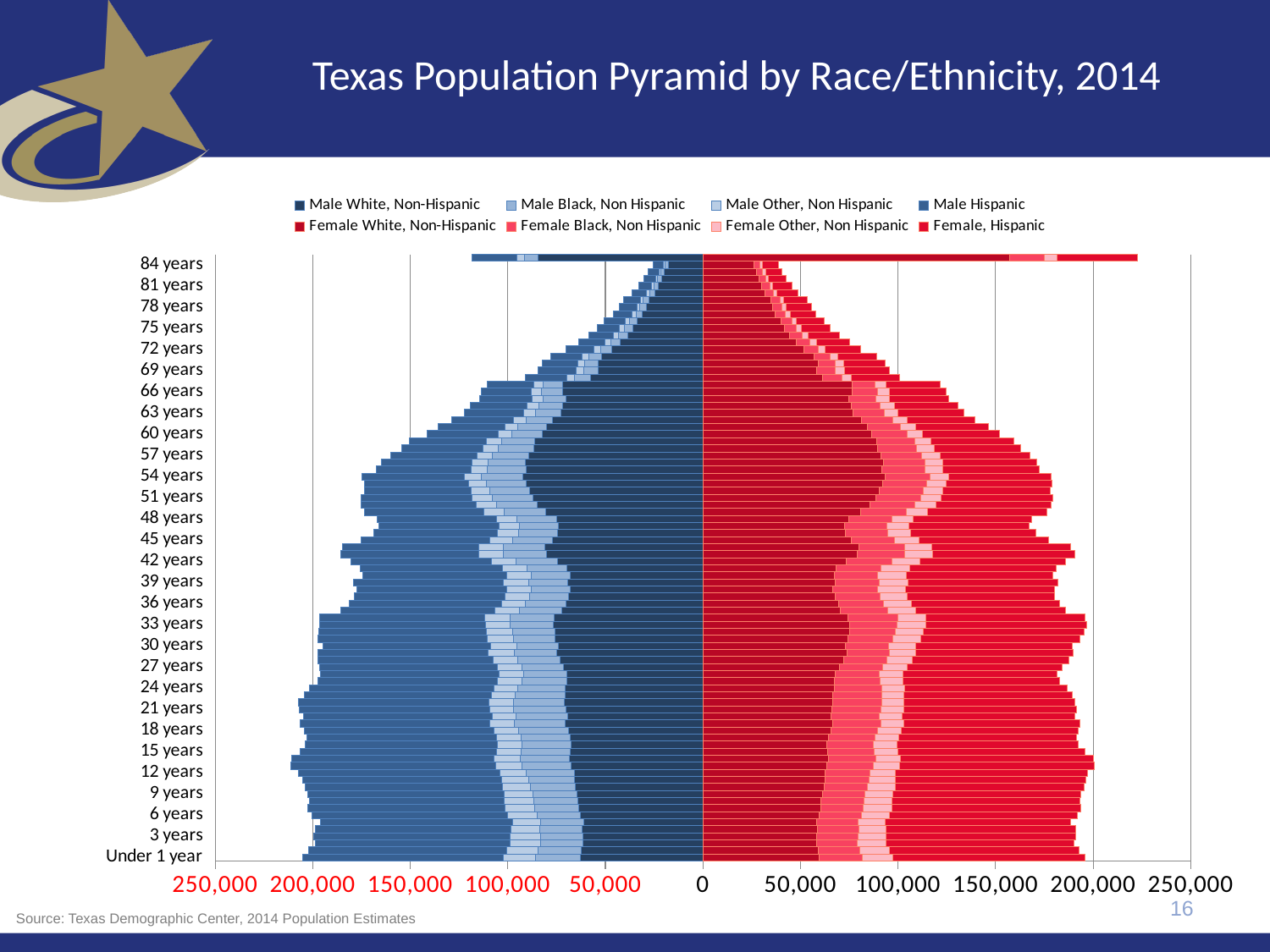
Which legend entry is shown in the darkest blue colour? Male White, Non-Hispanic Is the total male bar for 72 years greater or less than 50,000? greater What kind of chart is shown on the slide? Bar chart (population pyramid) Which is larger, the total male bar for 12 years or the total male bar for 78 years? 12 years How many series does the legend list? 8 Is the total male bar for 78 years greater or less than 50,000? less Is the total female bar for 66 years greater or less than 150,000? less What is the title of the chart? Texas Population Pyramid by Race/Ethnicity, 2014